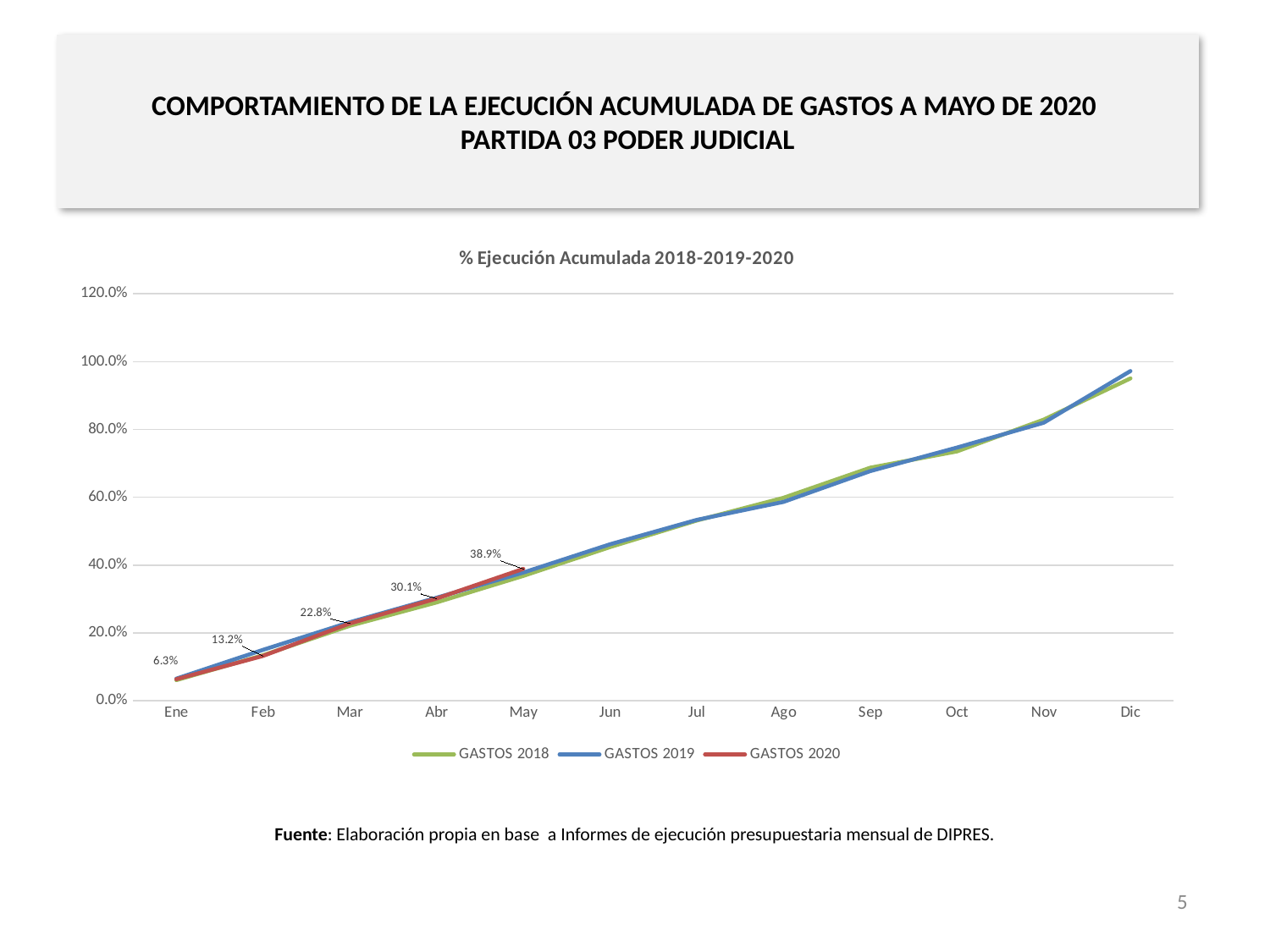
How many series does the legend list? 3 What is the difference between the GASTOS 2020 values for Feb and Ene? 6.9 percentage points What is the value for GASTOS 2020 in Ene? 6.3% Is the value for GASTOS 2018 in Dic greater or less than 100.0%? less What is the difference between the GASTOS 2020 values for May and Abr? 8.8 percentage points How many months are shown on the x axis? 12 Do the values for GASTOS 2019 rise or fall from Ene to Dic? Rise What kind of chart is shown on the slide? Line chart What is the value for GASTOS 2020 in May? 38.9% Which month has the highest labelled value for GASTOS 2020? May What is the value for GASTOS 2020 in Abr? 30.1% What is the value for GASTOS 2020 in Mar? 22.8%